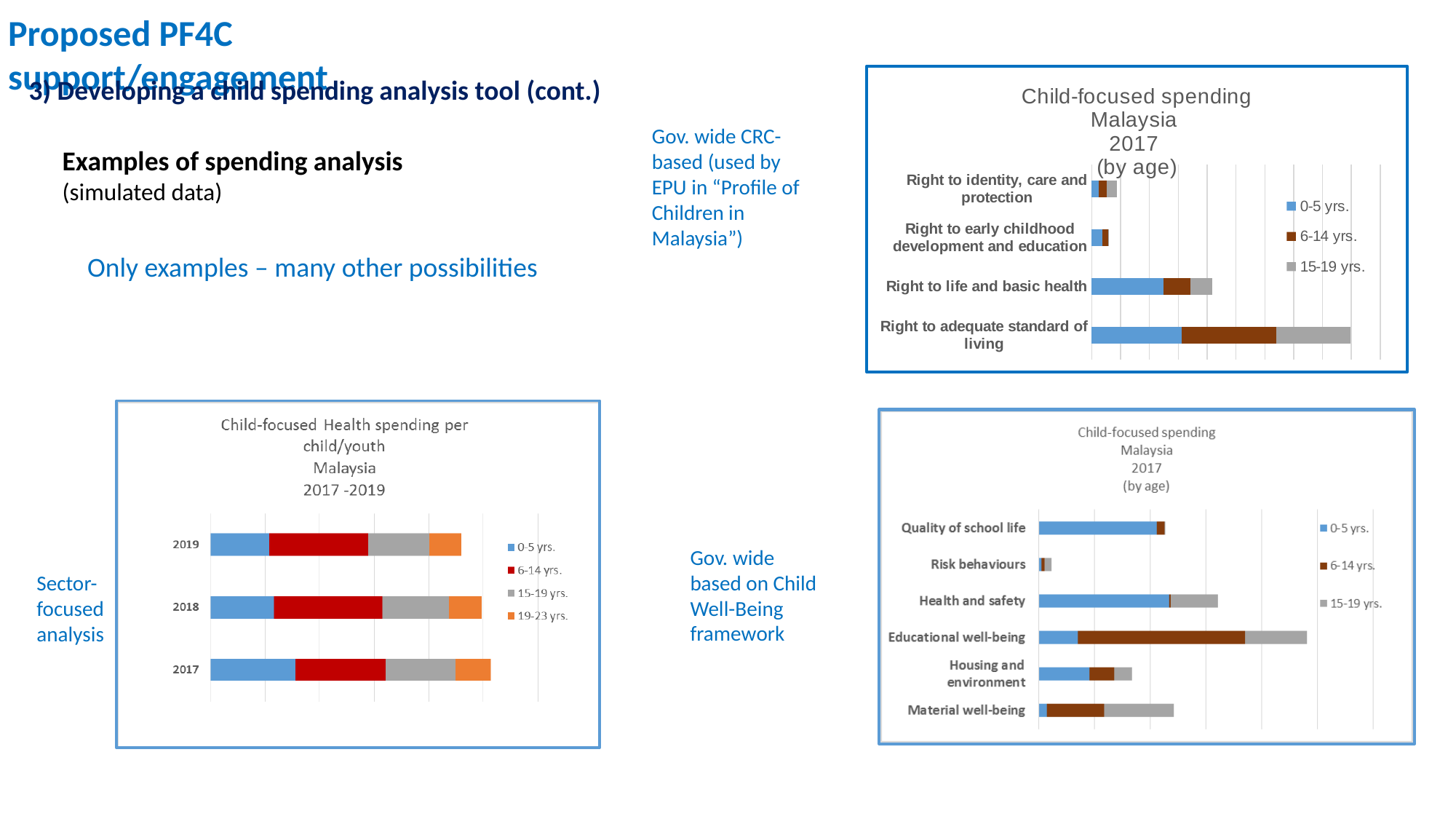
In the bottom-right chart (Child-focused spending Malaysia 2017 by age), which category has the longest total bar? Educational well-being In the bottom-left chart (Child-focused Health spending per child/youth Malaysia 2017-2019), how many years are shown? 3 In the bottom-left chart (Child-focused Health spending per child/youth Malaysia 2017-2019), which age group is shown in orange? 19-23 yrs. In the top-right chart (Child-focused spending Malaysia 2017 by age), which category has the longest total bar? Right to adequate standard of living In the bottom-left chart (Child-focused Health spending per child/youth Malaysia 2017-2019), which year has the longer total bar: 2017 or 2019? 2017 In the top-right chart (Child-focused spending Malaysia 2017 by age), which total bar is longer: Right to life and basic health or Right to identity, care and protection? Right to life and basic health In the top-right chart (Child-focused spending Malaysia 2017 by age), how many categories are shown? 4 What type of chart is the top-right chart titled 'Child-focused spending Malaysia 2017 (by age)'? Stacked bar chart In the bottom-right chart (Child-focused spending Malaysia 2017 by age), which category has the shortest total bar? Risk behaviours In the bottom-left chart (Child-focused Health spending per child/youth Malaysia 2017-2019), how many series does the legend list? 4 In the bottom-right chart (Child-focused spending Malaysia 2017 by age), how many categories are shown? 6 In the top-right chart (Child-focused spending Malaysia 2017 by age), how many series does the legend list? 3